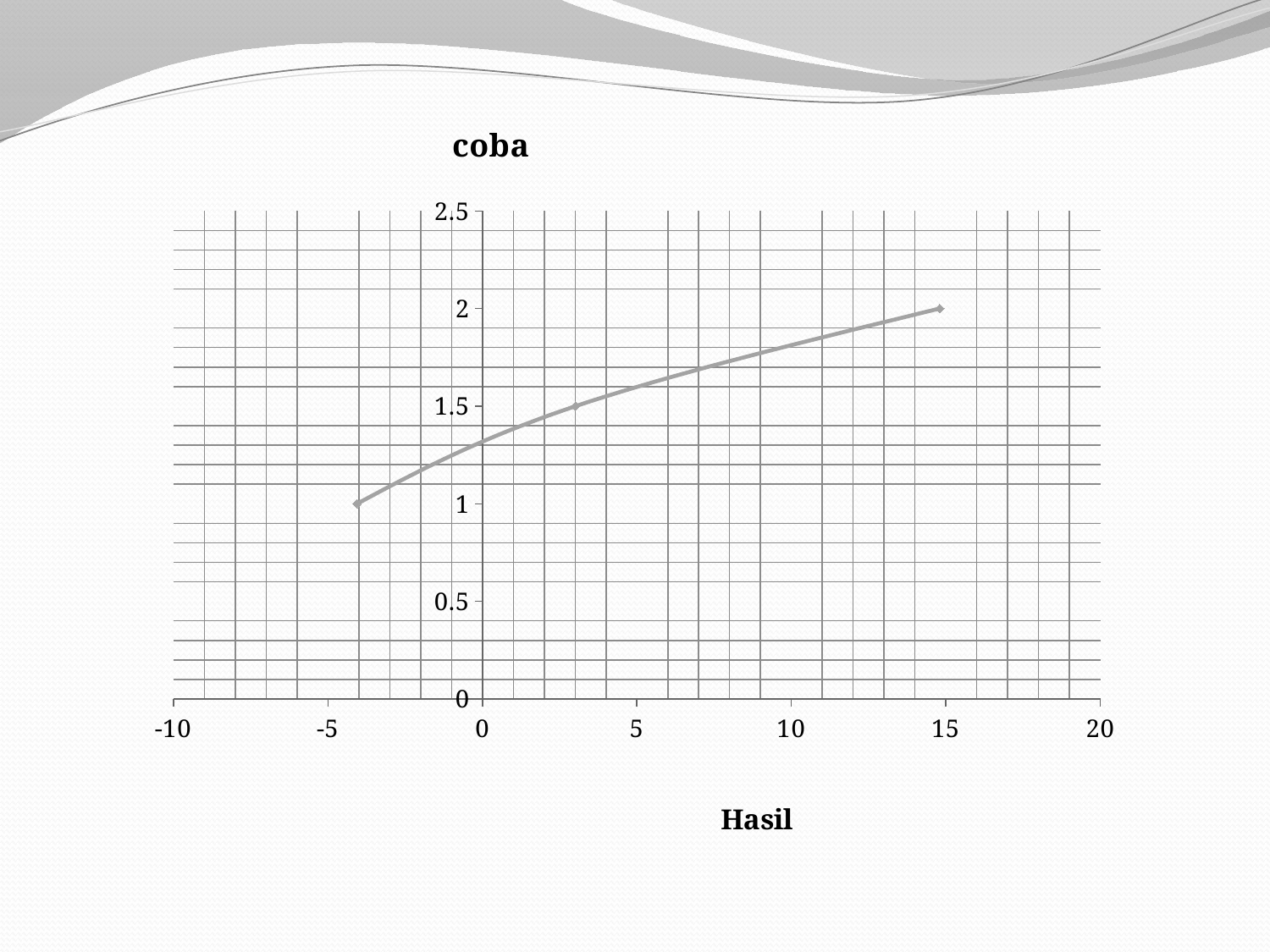
How many data points are plotted on the chart? 3 What is the highest value shown on the y axis? 2.5 What is the lowest y value reached by the plotted line? 1 What kind of chart is shown on the slide? line chart Is the y value of the leftmost plotted point greater or less than 1.5? less Is the y value of the rightmost plotted point greater or less than 1.5? greater What is the highest y value reached by the plotted line? 2 Which plotted point has the larger y value, the leftmost point or the rightmost point? the rightmost point What is the y value of the point plotted at x = 15? 2 What is the title of the chart? coba What is the label on the x axis of the chart? Hasil Do the plotted values rise or fall as you move from left to right along the x axis? rise